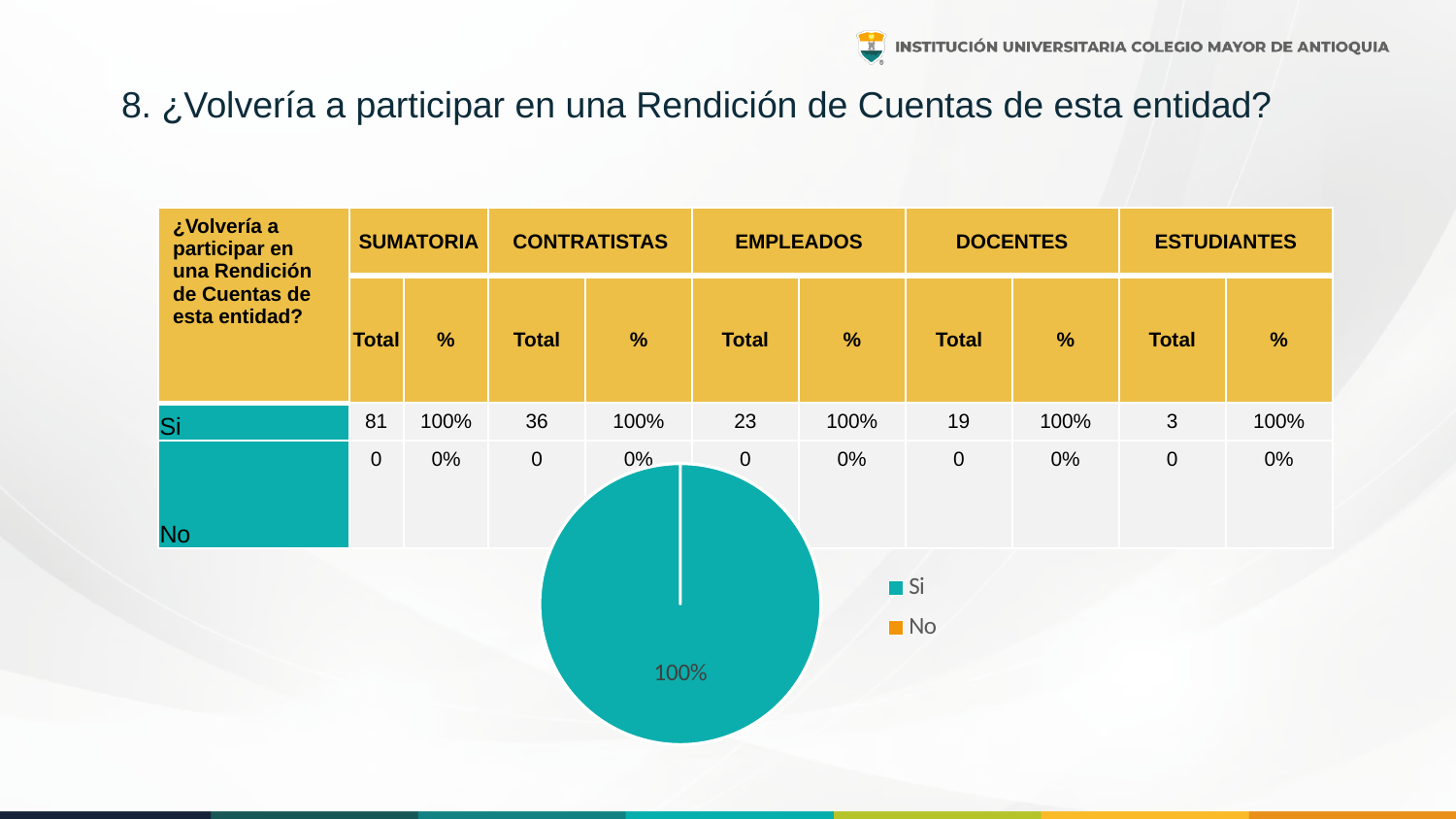
What colour is the "Si" slice in the pie chart? teal Is the share for "Si" in the pie chart greater or less than 50%? greater What percentage is printed as the data label on the pie chart? 100% Which category takes the smallest share of the pie chart? No What are the two legend entries of the pie chart? Si and No What kind of chart is shown on the slide? pie chart Which category takes the largest share of the pie chart? Si How many entries does the pie chart's legend list? 2 Which is larger in the pie chart, the share for "Si" or the share for "No"? Si What share of the pie chart does the "Si" slice take? 100%